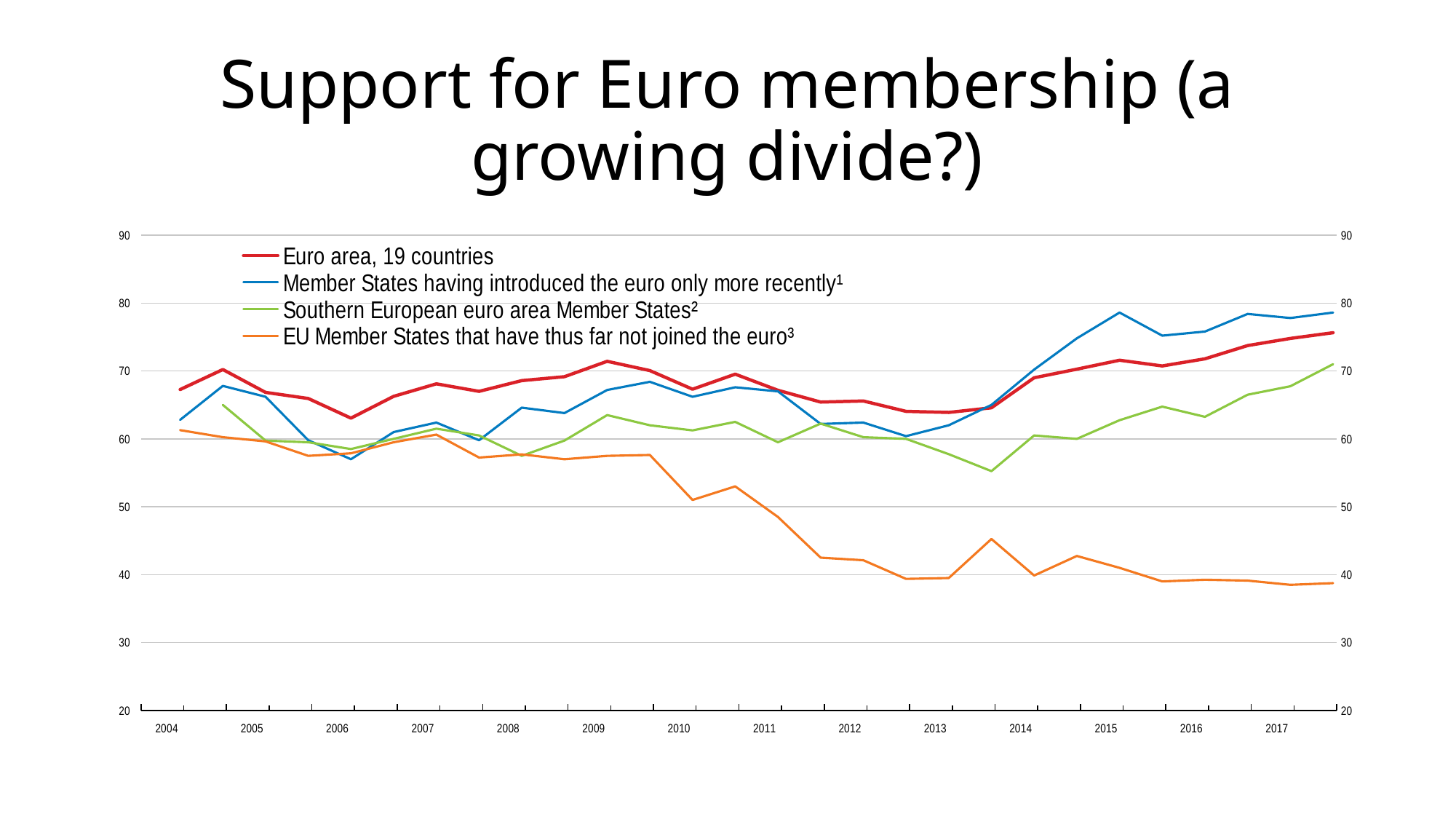
Which series has the lowest value at the end of the chart in 2017? EU Member States that have thus far not joined the euro How many year labels are shown on the x axis? 14 What colour is the line for Euro area, 19 countries? red What kind of chart is shown on the slide? line chart Does the line for EU Member States that have thus far not joined the euro rise or fall overall from 2004 to 2017? fall What is the title of the slide's chart? Support for Euro membership (a growing divide?) At the end of 2017, which is larger: Euro area, 19 countries or Southern European euro area Member States? Euro area, 19 countries Is the lowest point of the Southern European euro area Member States line greater or less than 60? less Is the value for EU Member States that have thus far not joined the euro at the end of 2017 greater or less than 40? less How many series does the legend list? 4 Is the value for Member States having introduced the euro only more recently in 2015 greater or less than 70? greater Which series has the highest value at the end of the chart in 2017? Member States having introduced the euro only more recently